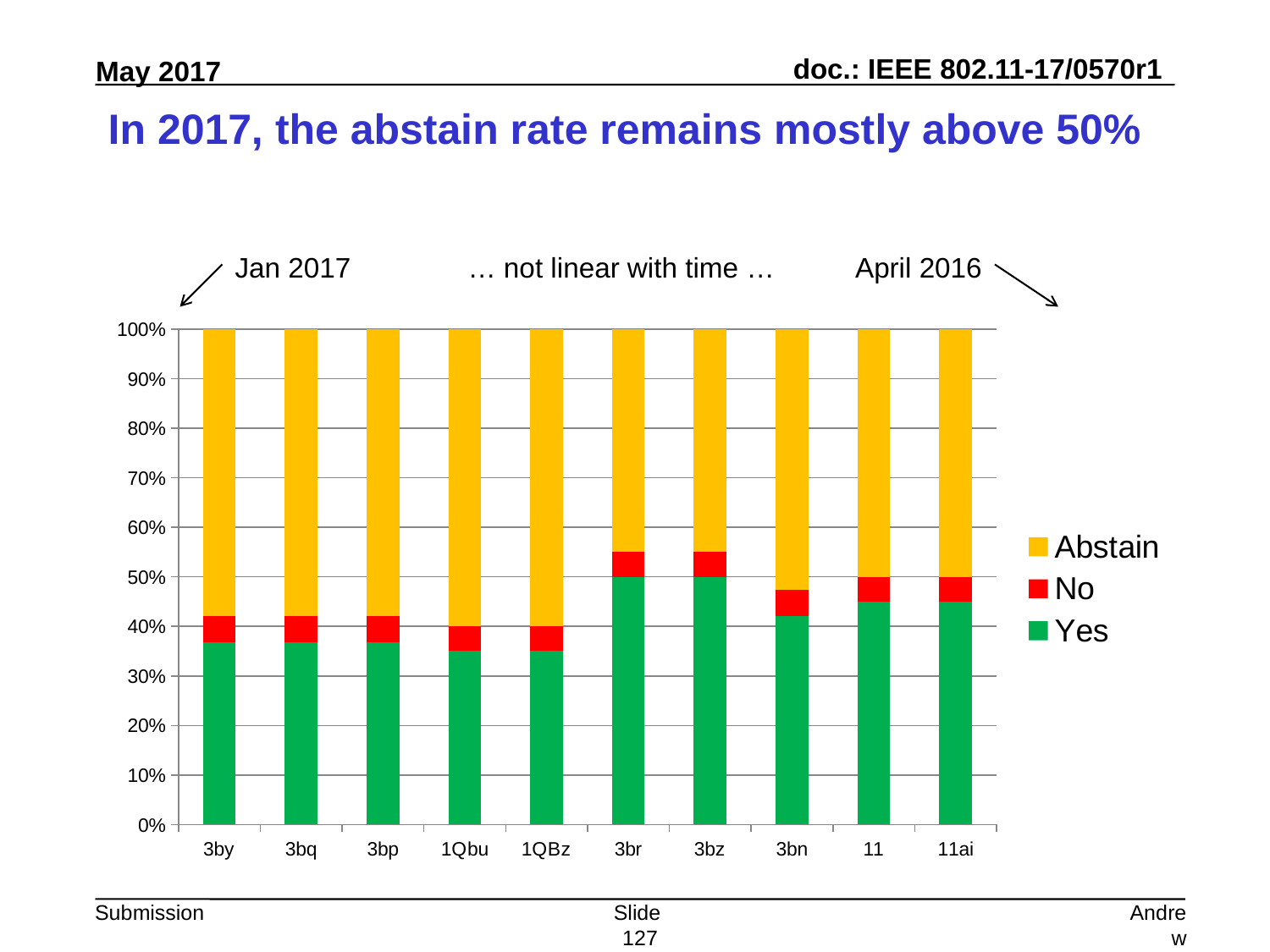
Which has a larger Abstain share, 3bq or 3bn? 3bq Is the Yes value for 11ai greater or less than 40%? greater Which has a larger Yes value, 3br or 3by? 3br What is the total height of the stacked bar for 3by? 100% What are the three series listed in the chart legend? Abstain, No, Yes How many categories are shown along the x axis of the chart? 10 Is the Yes value for 3by greater or less than 40%? less Which colour represents the Abstain series in the chart? yellow Is the Abstain share for 3by greater or less than 50%? greater What kind of chart is shown on the slide? stacked bar chart How many series does the chart legend list? 3